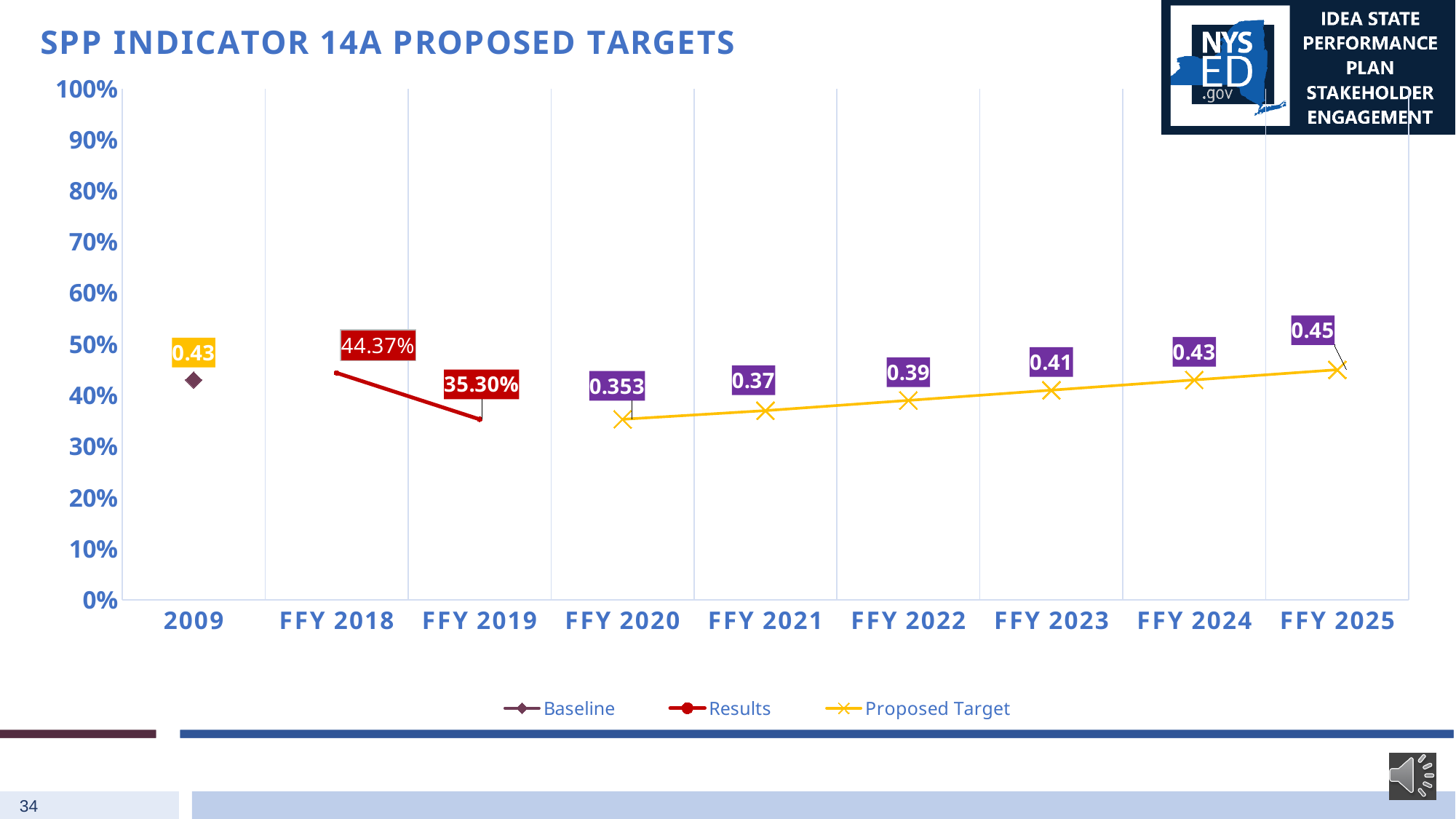
Which is larger, the Proposed Target for FFY 2022 or for FFY 2023? FFY 2023 What is the Proposed Target value for FFY 2025? 0.45 What is the Results value for FFY 2019? 35.30% Which year has the highest Proposed Target value? FFY 2025 What is the Baseline value shown for 2009? 0.43 What is the difference between the Results values for FFY 2018 and FFY 2019? 9.07% What is the Proposed Target value for FFY 2020? 0.353 What is the Results value for FFY 2018? 44.37% How many series does the legend list? 3 Do the Proposed Target values rise or fall from FFY 2020 to FFY 2025? Rise What kind of chart is shown on the slide? Line chart Which year has the lowest Proposed Target value? FFY 2020